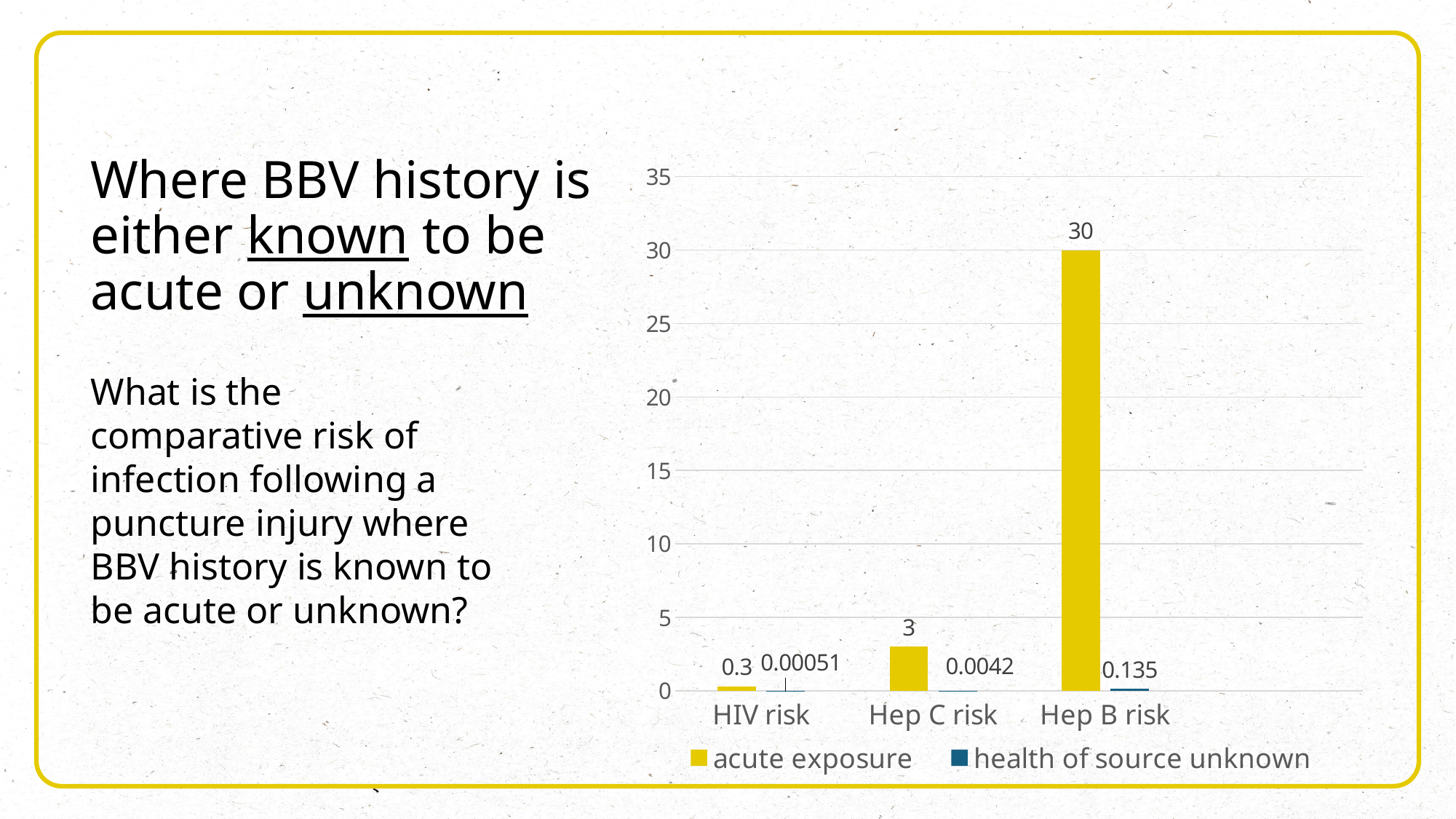
How many categories are shown on the x axis? 3 How many series does the legend list? 2 Which category has the lowest acute exposure value? HIV risk What kind of chart is shown on the slide? Bar chart Which series is shown in yellow in the legend? acute exposure What is the acute exposure value for Hep C risk? 3 What is the acute exposure value for Hep B risk? 30 Which is larger: the acute exposure value for Hep C risk or for HIV risk? Hep C risk What is the health of source unknown value for Hep B risk? 0.135 What is the health of source unknown value for HIV risk? 0.00051 What is the difference between the acute exposure values for Hep B risk and Hep C risk? 27 Which category has the highest acute exposure value? Hep B risk